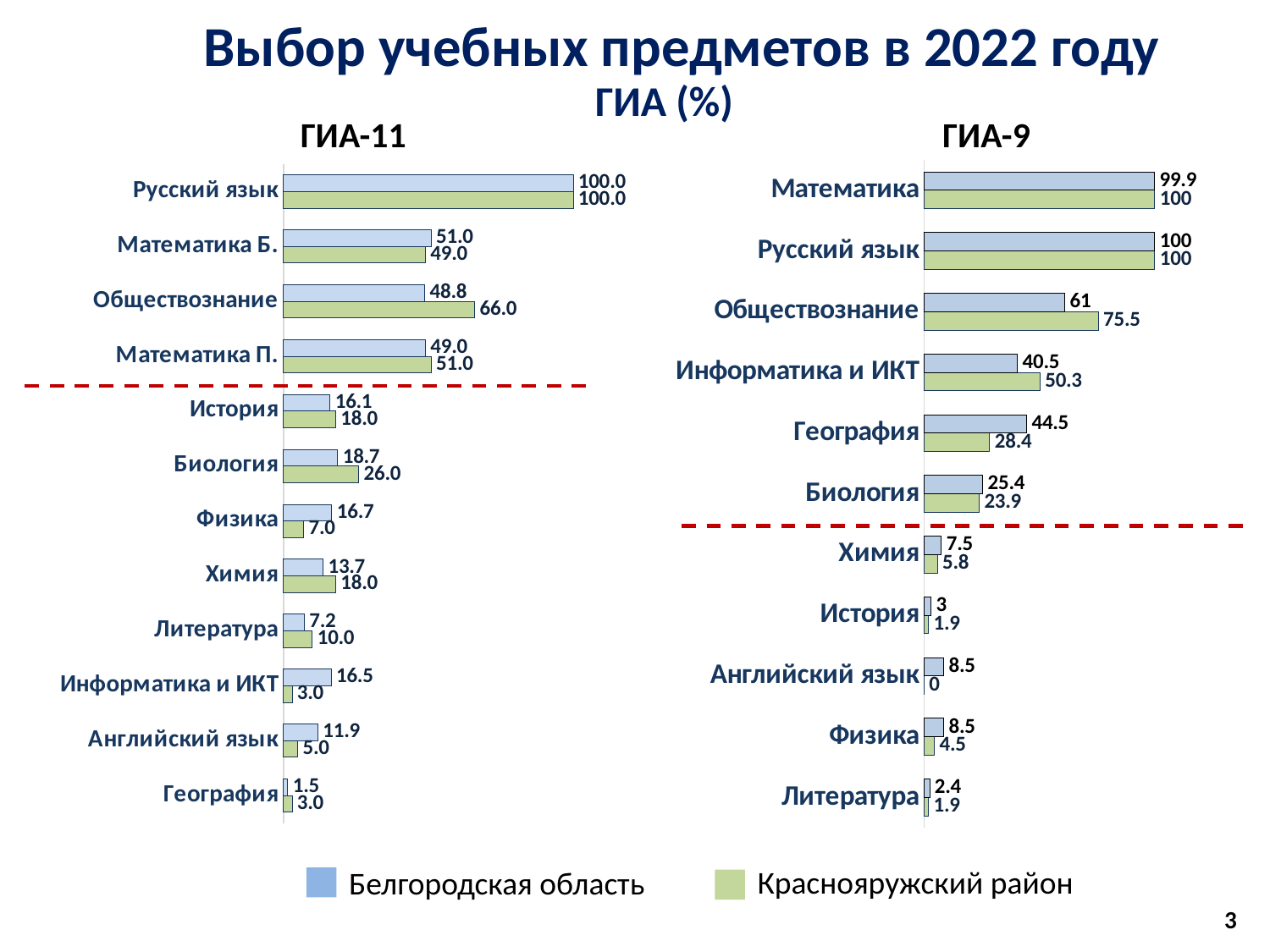
How many series does the legend list? 2 In the ГИА-11 chart, what is the value for Обществознание for Краснояружский район? 66.0 How many categories are shown in the ГИА-11 chart? 12 How many categories are shown in the ГИА-9 chart? 11 In the ГИА-11 chart, what is the value for Литература for Белгородская область? 7.2 In the ГИА-9 chart, what is the difference between the Краснояружский район and Белгородская область values for Обществознание? 14.5 In the ГИА-9 chart, what is the value for Информатика и ИКТ for Белгородская область? 40.5 What type of chart is the ГИА-9 chart? Bar chart In the ГИА-11 chart, which category has the lowest value for Белгородская область? География In the ГИА-11 chart, what is the difference between the Белгородская область and Краснояружский район values for Информатика и ИКТ? 13.5 In the ГИА-9 chart, which category has the lowest value for Краснояружский район? Английский язык In the ГИА-9 chart, which is larger for География: Белгородская область or Краснояружский район? Белгородская область